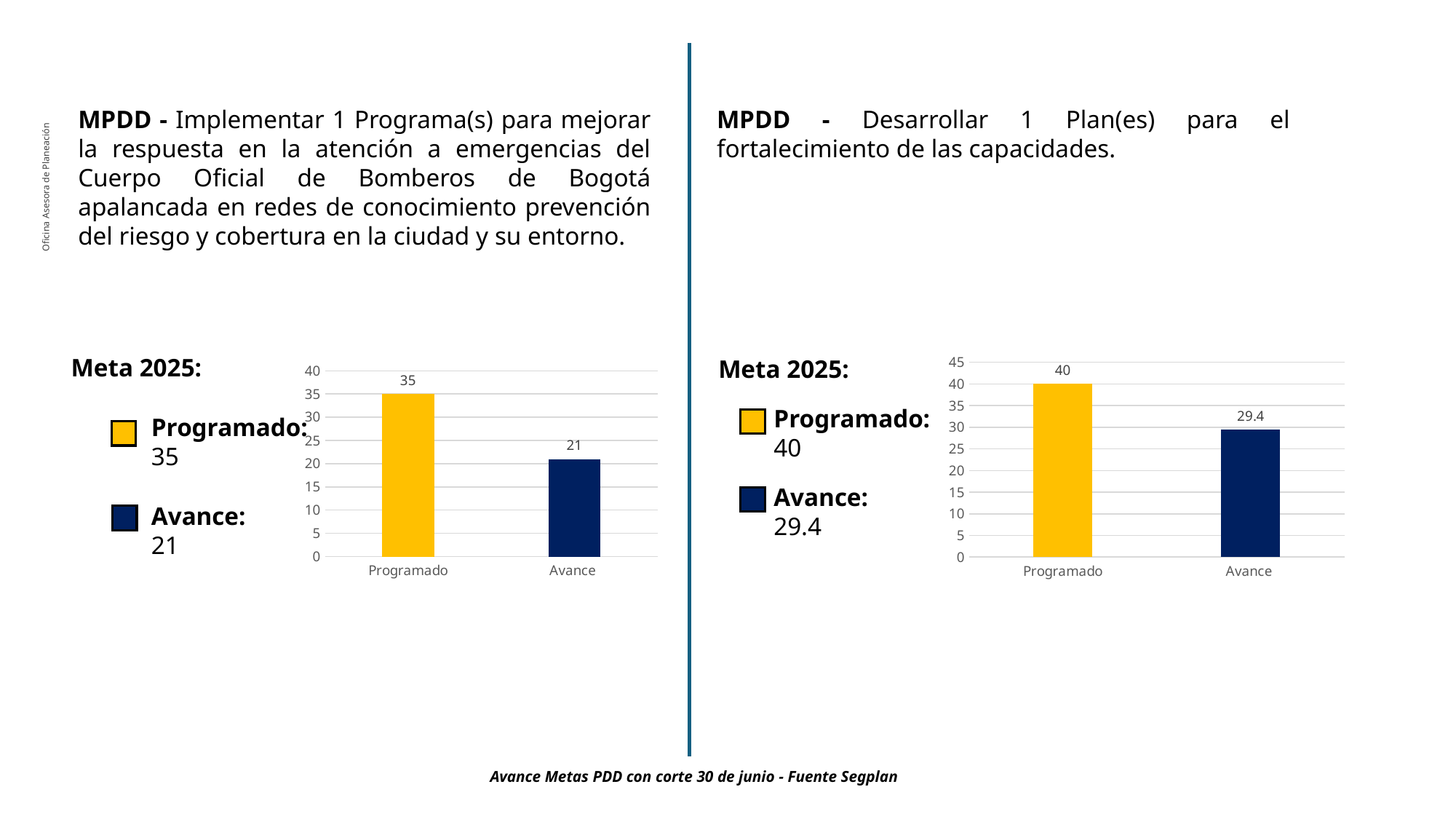
In the right chart, what is the value for Programado? 40 In the right chart, is the value for Avance greater or less than 30? less In the left chart, what is the value for Avance? 21 In the left chart, which category has the highest value? Programado In the right chart, which category has the lowest value? Avance In the right chart, what is the value for Avance? 29.4 In the right chart, what is the difference between Programado and Avance? 10.6 How many categories does the left chart show? 2 In the left chart, what is the difference between Programado and Avance? 14 What kind of chart is the right chart? bar chart In the left chart, what is the value for Programado? 35 In the left chart, what colour is the Programado bar? yellow